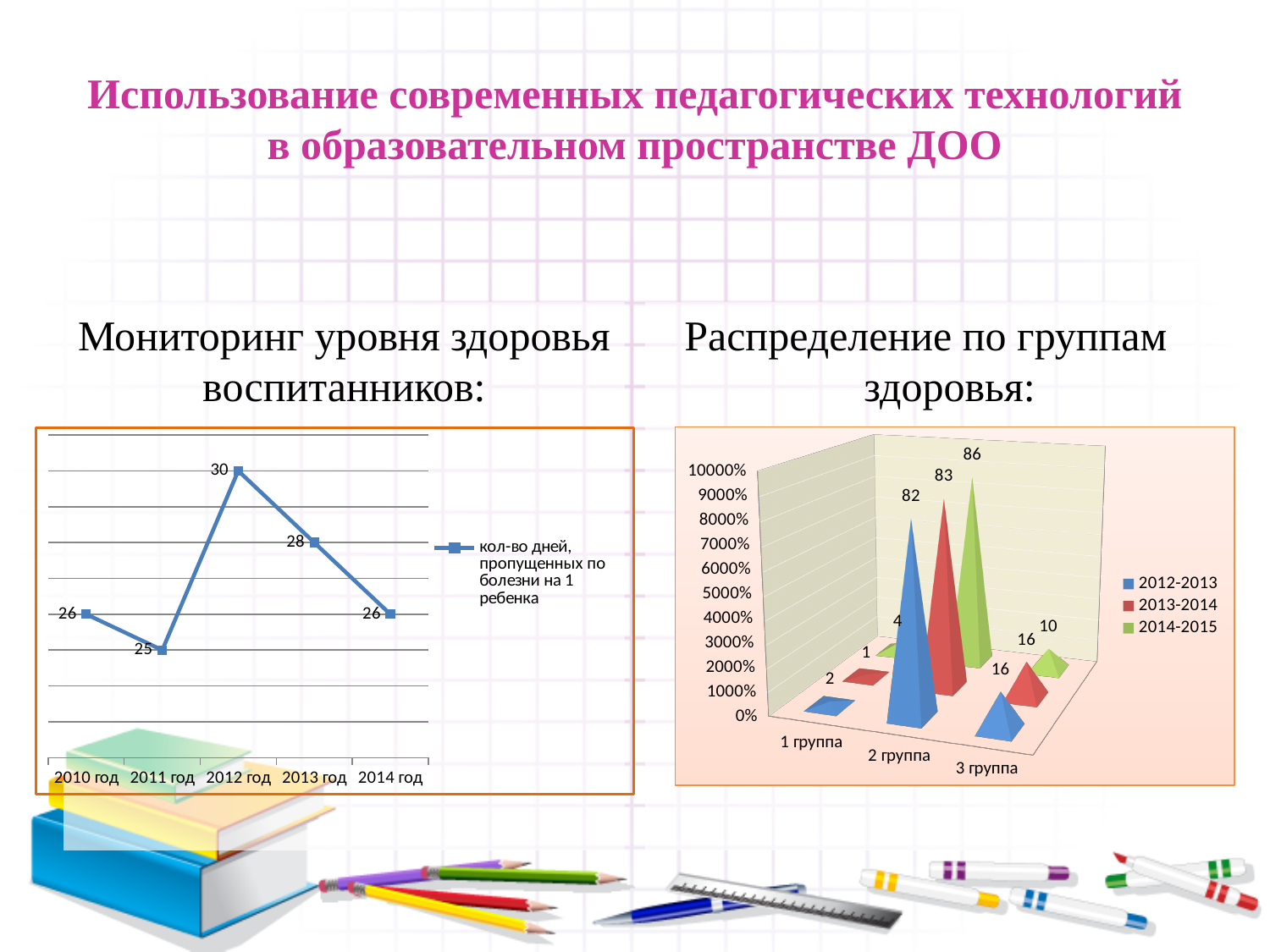
On the left chart (Мониторинг уровня здоровья воспитанников), what is the value for 2012 год? 30 On the right chart (Распределение по группам здоровья), what is the value for 1 группа in the 2013-2014 series? 1 On the left chart (Мониторинг уровня здоровья воспитанников), which year has the lowest value? 2011 год On the right chart (Распределение по группам здоровья), what is the value for 2 группа in the 2014-2015 series? 86 On the right chart (Распределение по группам здоровья), how many series does the legend list? 3 On the left chart (Мониторинг уровня здоровья воспитанников), how many years are plotted on the x axis? 5 On the right chart (Распределение по группам здоровья), which is larger: the 2012-2013 value for 3 группа or the 2014-2015 value for 3 группа? 2012-2013 On the right chart (Распределение по группам здоровья), what is the difference between the 2014-2015 value and the 2012-2013 value for 2 группа? 4 What kind of chart is the left chart (Мониторинг уровня здоровья воспитанников)? line chart On the left chart (Мониторинг уровня здоровья воспитанников), what is the difference between the values for 2012 год and 2013 год? 2 On the left chart (Мониторинг уровня здоровья воспитанников), what is the value for 2011 год? 25 On the left chart (Мониторинг уровня здоровья воспитанников), which year has the highest value? 2012 год